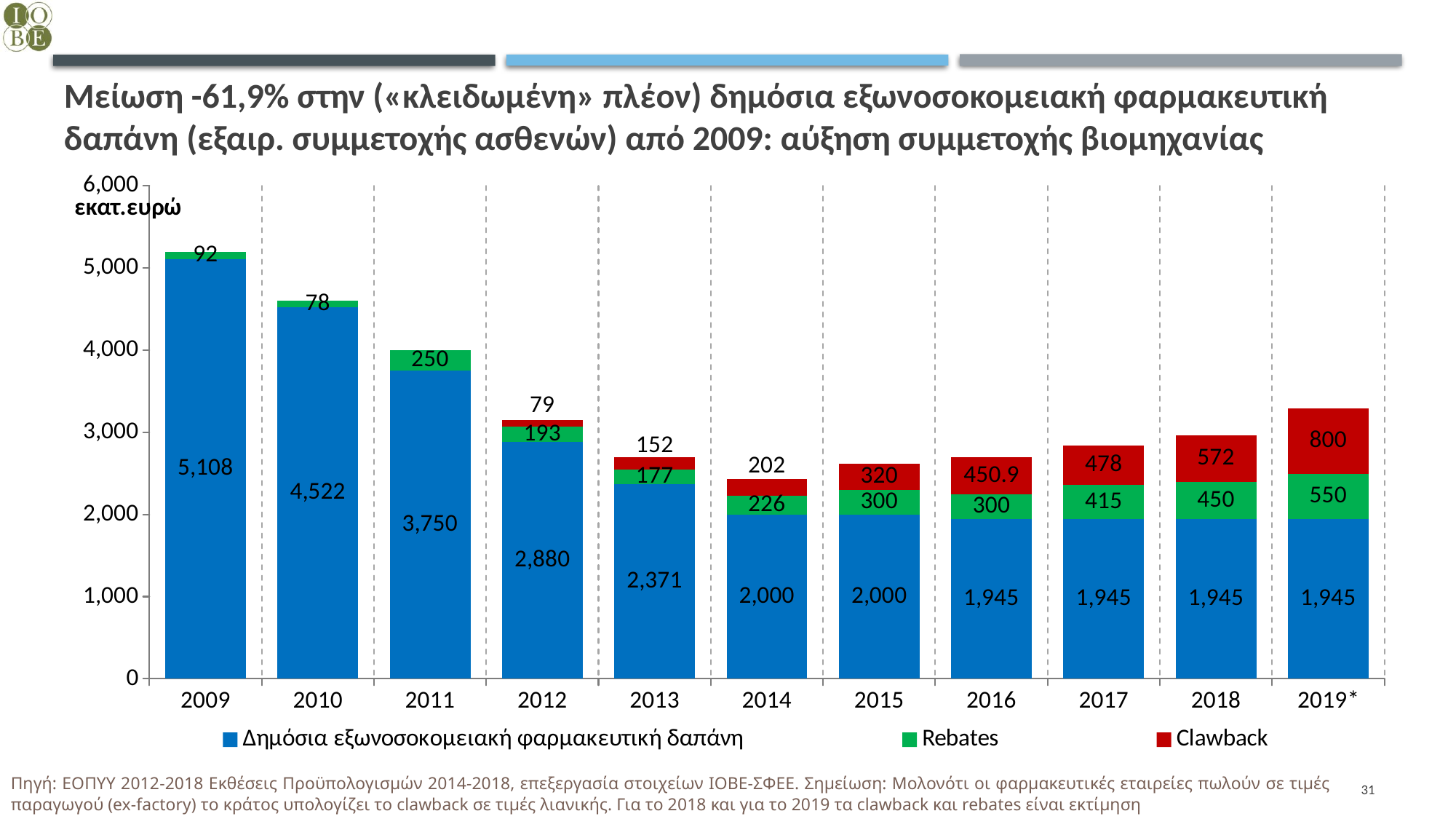
What is the Rebates value for 2011? 250 Is the total stacked bar for 2011 greater or less than 3,000? greater What is the Clawback value for 2016? 450.9 Which year has the lowest Rebates value? 2010 Which year has the highest Clawback value? 2019* How many series does the legend list? 3 What is the difference between the Clawback values for 2019* and 2018? 228 How many years are shown on the x axis? 11 What is the total of the stacked bar for 2012? 3,152 What kind of chart is shown on the slide? Stacked bar chart What is the value of Δημόσια εξωνοσοκομειακή φαρμακευτική δαπάνη for 2009? 5,108 Which is larger in 2015, Rebates or Clawback? Clawback